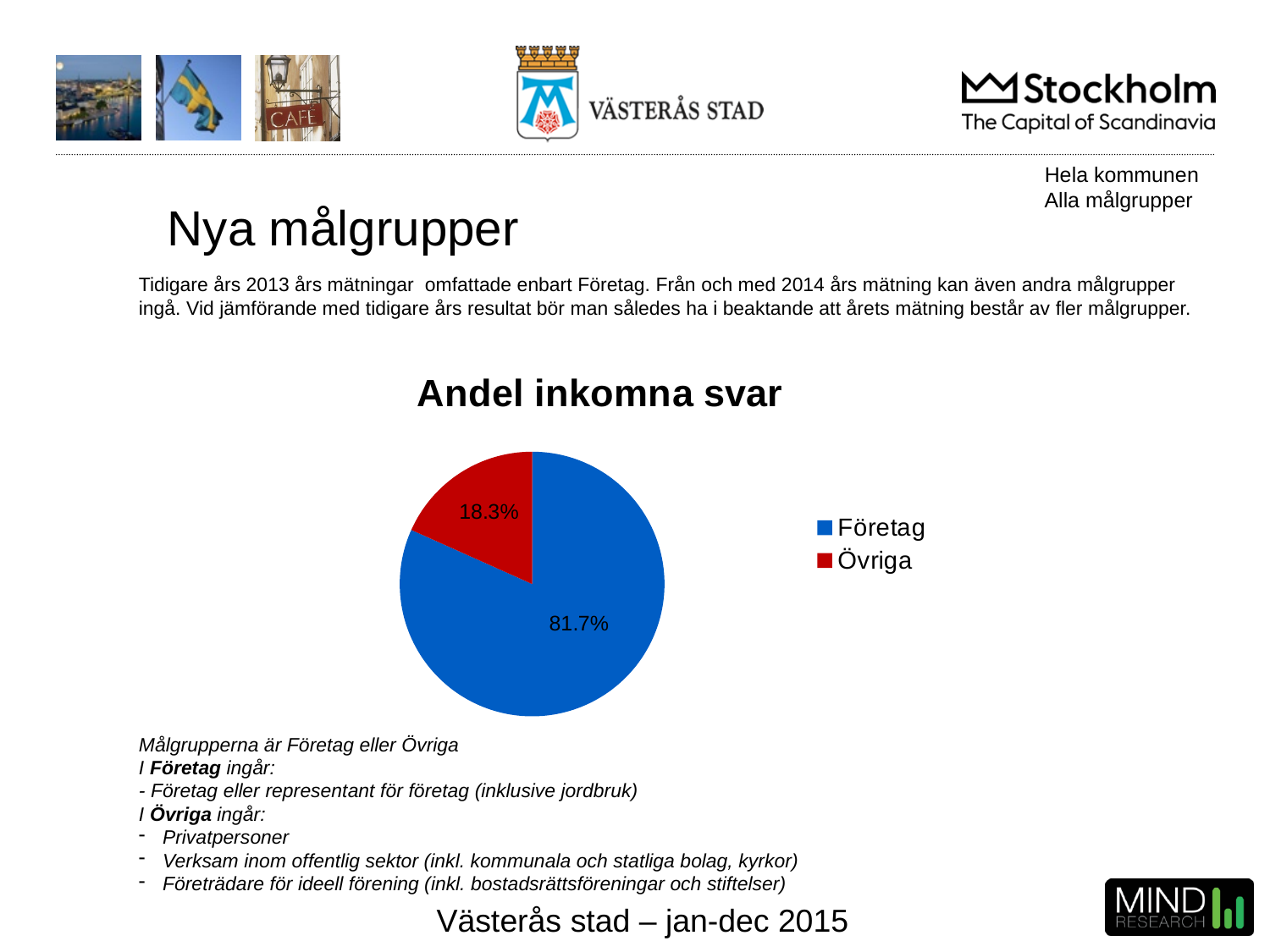
What type of chart is shown on the slide? pie chart Which is larger, the Företag slice or the Övriga slice? Företag Which category has the largest slice of the pie? Företag How many slices does the pie chart have? 2 Which category has the smallest slice of the pie? Övriga What share of the pie does Företag represent? 81.7% What is the title of the chart? Andel inkomna svar What is the difference in percentage points between the Företag and Övriga slices? 63.4 How many entries does the legend list? 2 What share of the pie does Övriga represent? 18.3% What colour is the Övriga slice? red